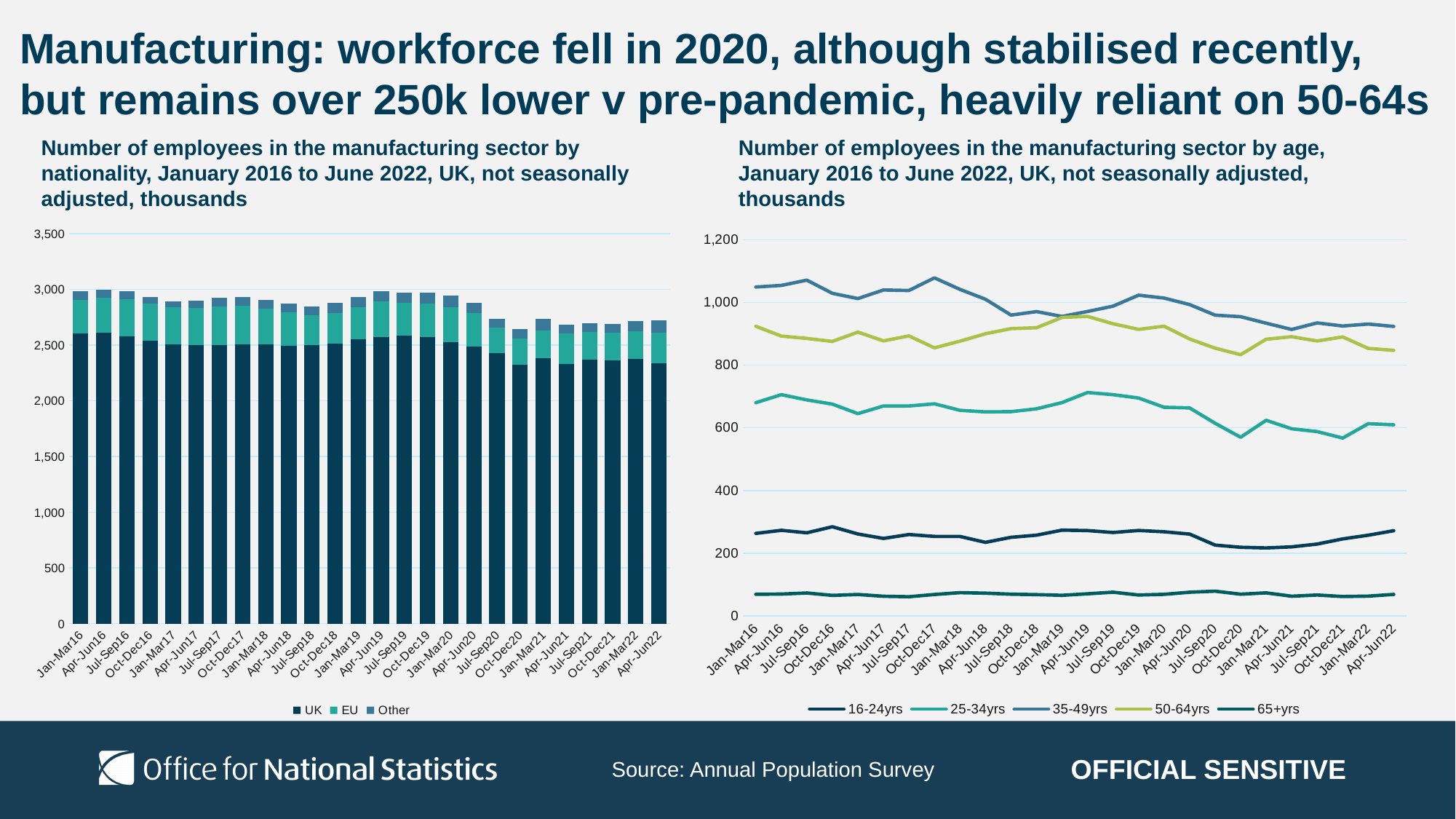
In the left chart (by nationality), which nationality group makes up the largest part of each bar? UK In the right chart (by age), which is larger in Apr-Jun22: the value for 50-64yrs or the value for 25-34yrs? 50-64yrs In the right chart (by age), which age group has the lowest number of employees across the whole period? 65+yrs In the right chart (by age), is the value for 25-34yrs in Oct-Dec20 greater or less than 600? less How many series does the legend of the left chart (by nationality) list? 3 What kind of chart is the left chart, 'Number of employees in the manufacturing sector by nationality'? Stacked bar chart In the left chart (by nationality), is the UK segment for Jan-Mar16 greater or less than 2,500? greater In the right chart (by age), which age group has the highest number of employees across the whole period? 35-49yrs In the right chart (by age), is the value for 35-49yrs in Jan-Mar16 greater or less than 1,000? greater What kind of chart is the right chart, 'Number of employees in the manufacturing sector by age'? Line chart How many quarterly periods are plotted on the x axis of the right chart (by age)? 26 How many series does the legend of the right chart (by age) list? 5